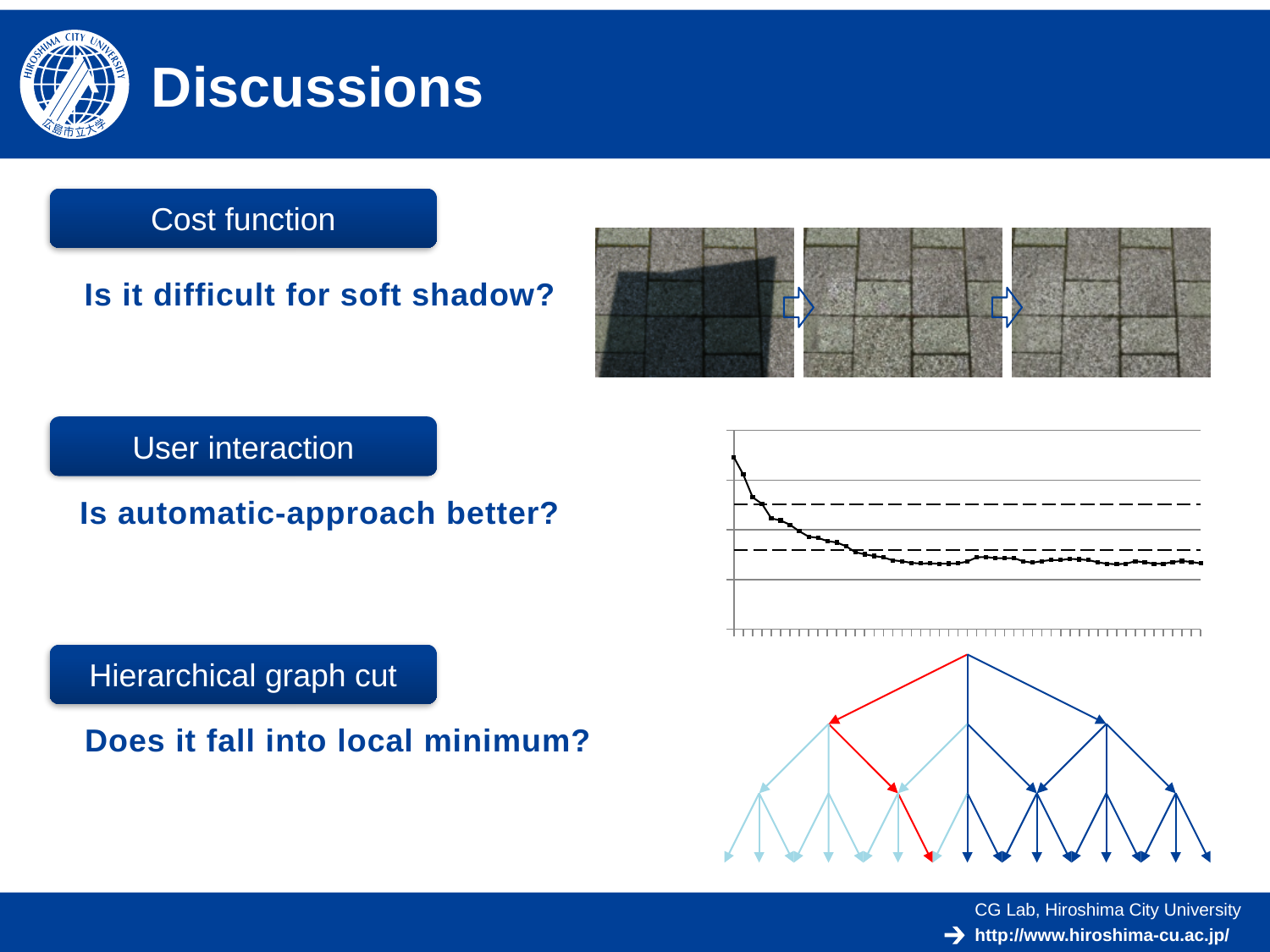
What colour is the plotted line in the line chart on the right of the slide? black How many data series are plotted in the line chart on the right of the slide? 3 In the line chart on the right of the slide, do the plotted values generally rise or fall from left to right along the x axis? fall How many dashed horizontal lines are drawn across the line chart on the right of the slide? 2 What kind of chart is shown on the right side of the slide, next to the 'User interaction' section? line chart In the line chart on the right of the slide, is the first point on the left higher or lower than the last point on the right? higher